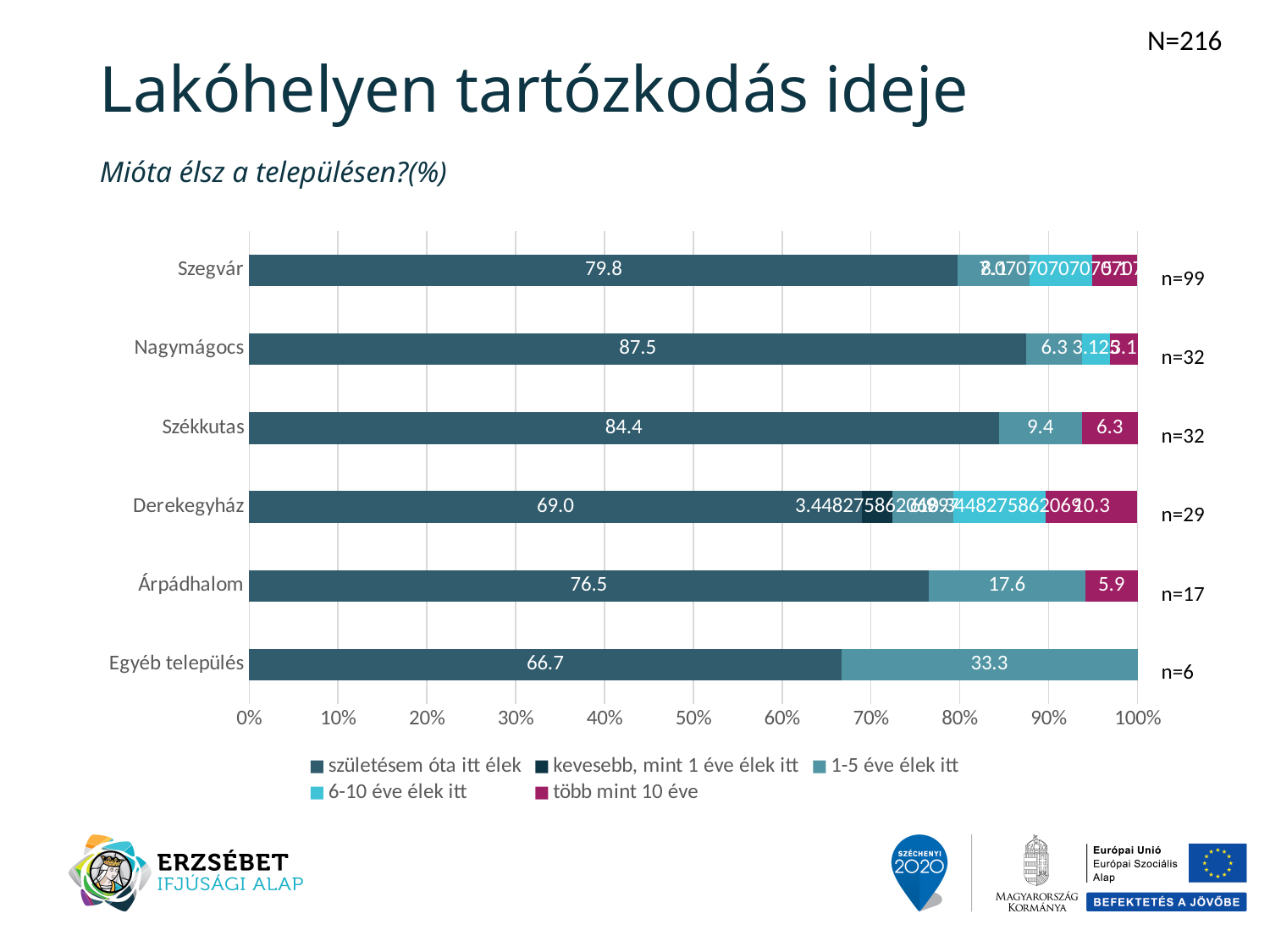
What is the value of 'születésem óta itt élek' for Derekegyház? 69.0 What is the value of 'születésem óta itt élek' for Nagymágocs? 87.5 What is the difference between the 'születésem óta itt élek' values for Székkutas and Árpádhalom? 7.9 Which settlement has the lowest value for 'születésem óta itt élek'? Egyéb település What is the sample size (n) shown for Szegvár? n=99 What is the value of 'több mint 10 éve' for Székkutas? 6.3 How many series does the legend list? 5 What type of chart is shown on the slide? stacked bar chart Which settlement has the highest value for 'születésem óta itt élek'? Nagymágocs What is the value of '1-5 éve élek itt' for Árpádhalom? 17.6 Which is larger: the 'születésem óta itt élek' value for Szegvár or for Derekegyház? Szegvár How many settlement categories are shown on the chart? 6